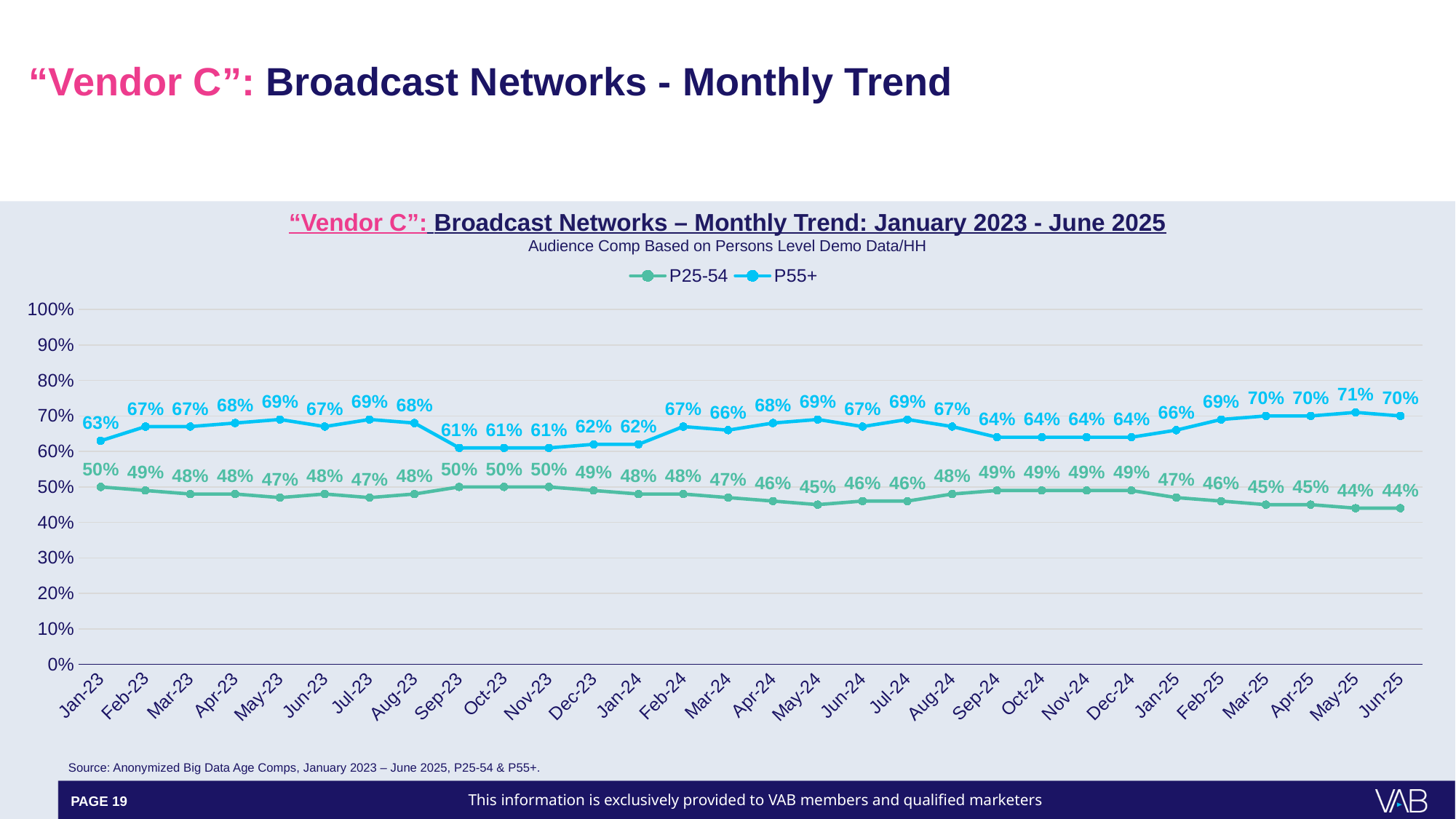
What type of chart is shown on the slide? line chart Does the P25-54 series rise or fall from Jan-23 to Jun-25? fall What is the subtitle shown under the chart title? Audience Comp Based on Persons Level Demo Data/HH What is the P55+ value for Sep-23? 61% Which is larger, the P25-54 value for Jan-23 or the P25-54 value for Jun-25? Jan-23 In which month does the P55+ series reach its highest value? May-25 What is the P25-54 value for May-24? 45% What is the P55+ value for Jan-23? 63% How many series does the legend list? 2 How many months are plotted on the x axis? 30 What is the difference between the P55+ values for Aug-23 and Sep-23? 7% What is the difference between the P55+ and P25-54 values in Jun-25? 26%